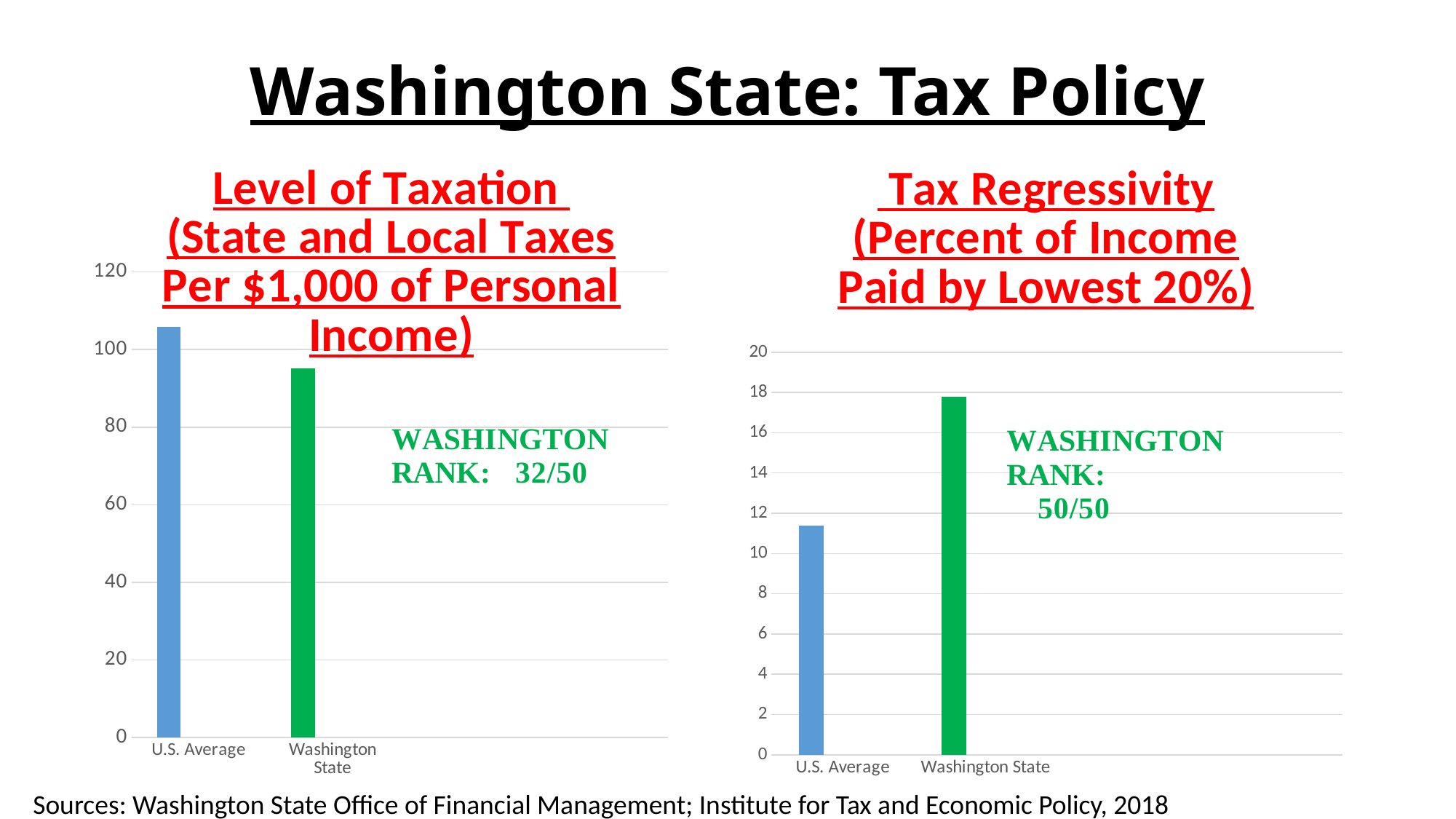
In the Level of Taxation chart, how many categories are plotted? 2 In the Level of Taxation chart, which category has the higher value? U.S. Average In the Tax Regressivity chart, is the value for U.S. Average greater or less than 12? less What Washington rank is shown next to the Level of Taxation chart? 32/50 In the Level of Taxation chart, what kind of chart is shown? bar chart In the Tax Regressivity chart, is the value for Washington State greater or less than 16? greater What Washington rank is shown next to the Tax Regressivity chart? 50/50 In the Level of Taxation chart, is the value for U.S. Average greater or less than 100? greater In the Tax Regressivity chart, how many categories are plotted? 2 In the Tax Regressivity chart, which is larger, the value for U.S. Average or the value for Washington State? Washington State In the Tax Regressivity chart, which category has the lower value? U.S. Average